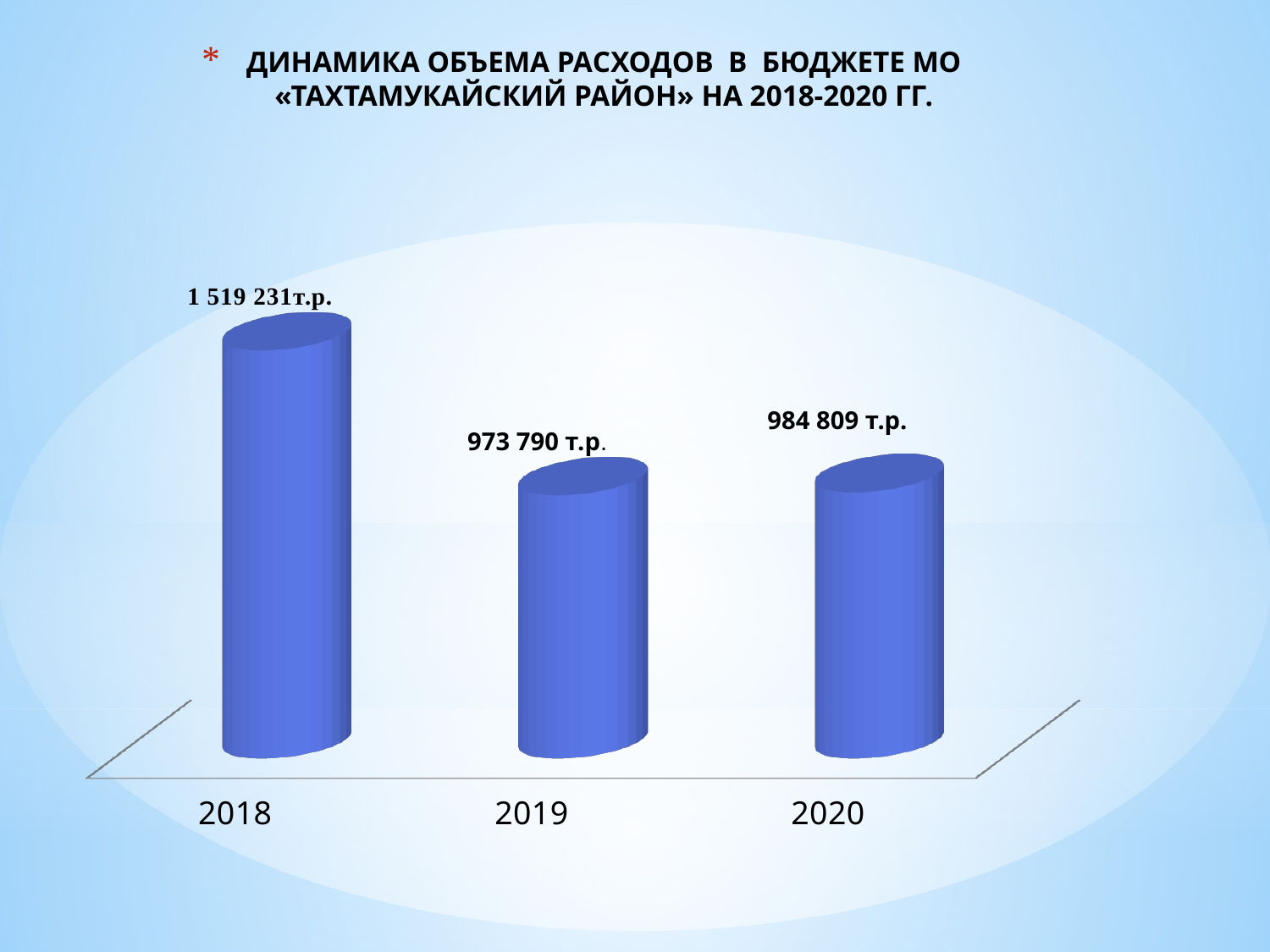
What is the value for 2018? 1 519 231т.р. What is the difference between the values for 2020 and 2019? 11 019 т.р. What is the value for 2020? 984 809 т.р. What is the value for 2019? 973 790 т.р. What kind of chart is shown on the slide? Bar chart Do the values rise or fall from 2018 to 2019? Fall How many years are shown on the chart? 3 What is the difference between the values for 2018 and 2020? 534 422 т.р. What is the difference between the values for 2018 and 2019? 545 441 т.р. Which is larger, the value for 2019 or the value for 2020? 2020 Which year has the highest value? 2018 Which year has the lowest value? 2019